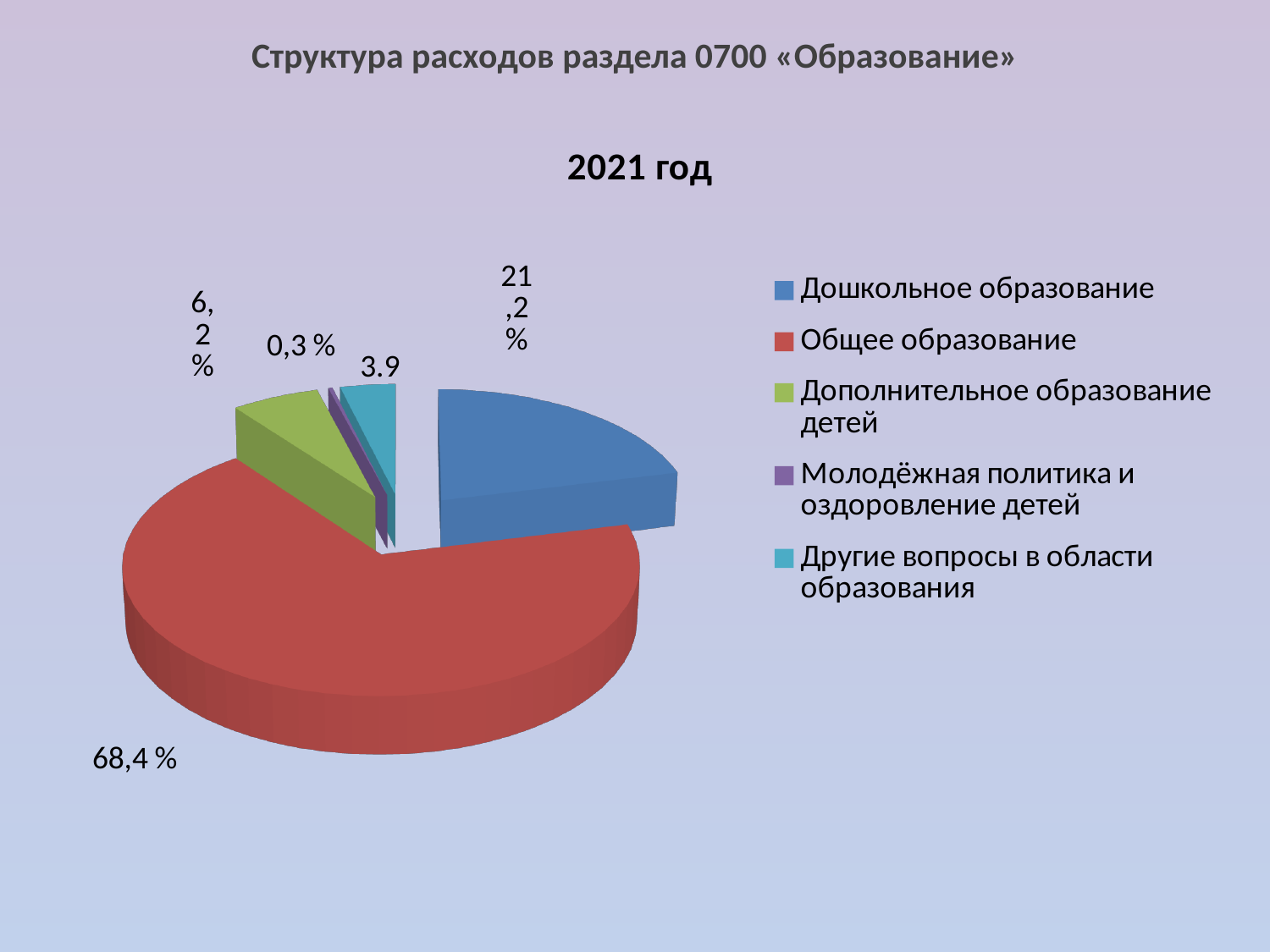
What colour is the slice for Общее образование? red What kind of chart is shown on the slide? pie chart Which is larger, Дошкольное образование or Дополнительное образование детей? Дошкольное образование Which category has the smallest share of the pie? Молодёжная политика и оздоровление детей What is the chart's title? 2021 год Which category has the largest share of the pie? Общее образование How many categories does the legend list? 5 What is the value labelled for Другие вопросы в области образования? 3.9 What is the value for Дополнительное образование детей? 6,2 % What is the value for Общее образование? 68,4 % What is the value for Молодёжная политика и оздоровление детей? 0,3 % What is the value for Дошкольное образование? 21,2 %